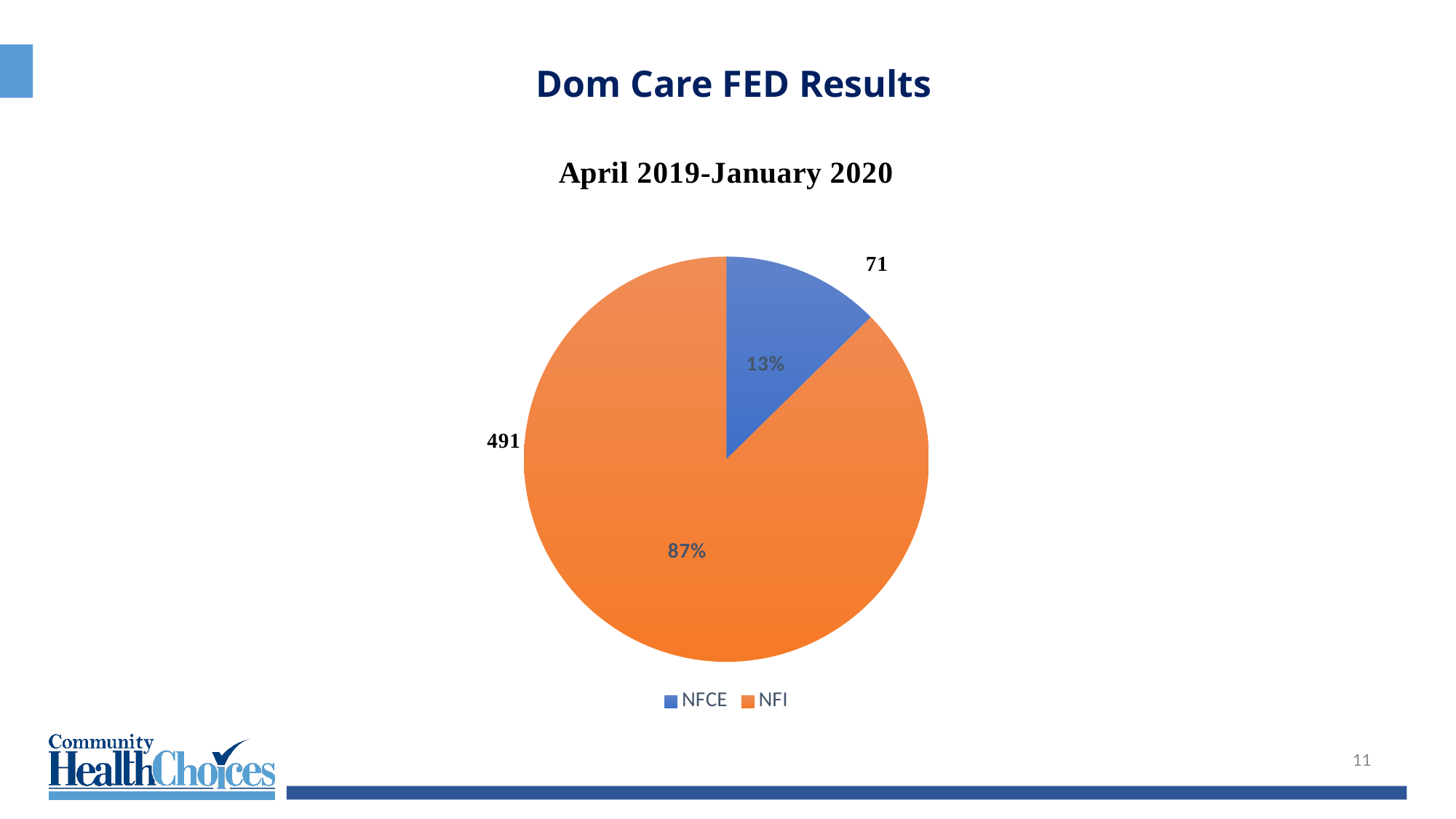
Which is larger, the value for NFCE or the value for NFI? NFI What is the title of the chart? April 2019-January 2020 How many categories does the pie chart show? 2 What percentage share of the pie does NFI have? 87% What is the value for NFCE? 71 What percentage share of the pie does NFCE have? 13% What is the difference between the NFI value and the NFCE value? 420 What kind of chart is shown on the slide? Pie chart What is the value for NFI? 491 What is the total of the two values shown in the pie chart? 562 Which category has the largest slice of the pie? NFI Which category has the smallest slice of the pie? NFCE